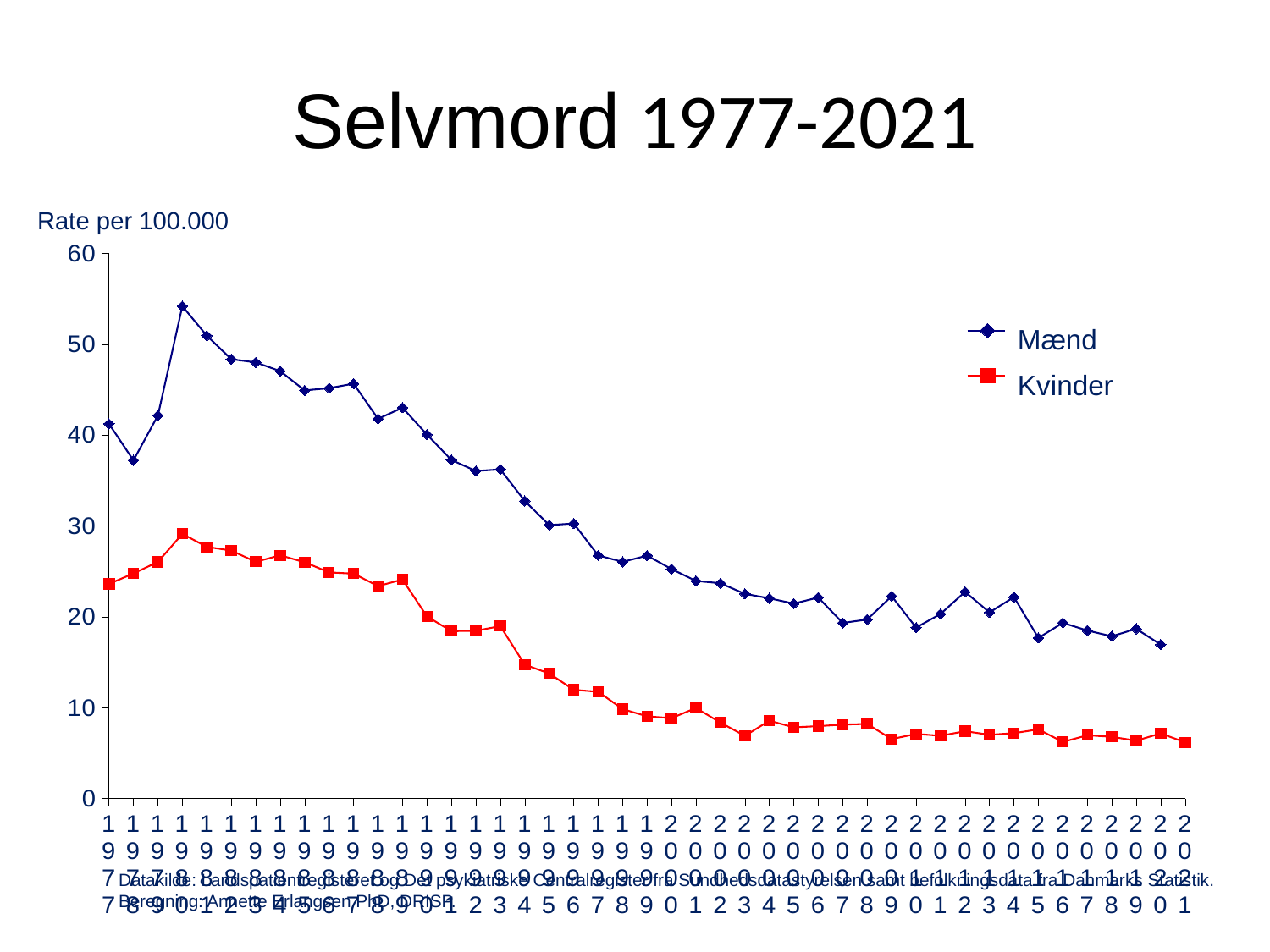
In which year does the Mænd series reach its highest value? 1980 What are the two series named in the legend? Mænd and Kvinder Is the value for Kvinder in 1995 greater or less than 20? less Do the values for Kvinder generally rise or fall from 1980 to 2021? fall In which year does the Kvinder series reach its highest value? 1980 How many series does the legend list? 2 Which series has the larger value in 1990, Mænd or Kvinder? Mænd Is the value for Mænd in 1980 greater or less than 50? greater What is the title of the chart? Selvmord 1977-2021 What kind of chart is shown on the slide? line chart Is the value for Kvinder in 2021 greater or less than 10? less